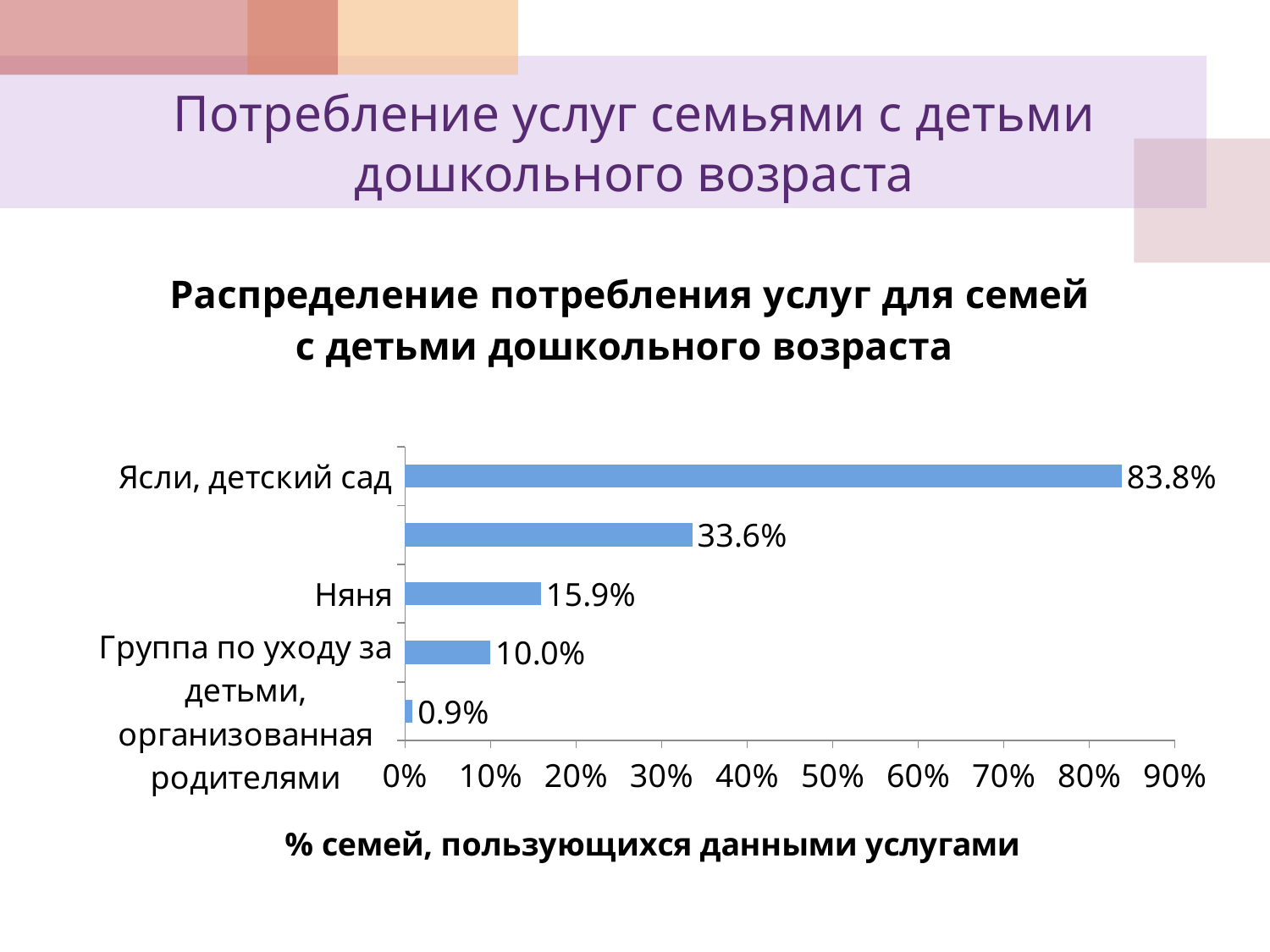
What is the value for "Ясли, детский сад"? 83.8% What is the value of the shortest bar? 0.9% What is the difference between the values for "Ясли, детский сад" and "Няня"? 67.9% Which is larger, the value for "Ясли, детский сад" or the value for "Няня"? Ясли, детский сад How many bars are plotted in the chart? 5 What is the label of the horizontal axis? % семей, пользующихся данными услугами What is the value of the longest bar? 83.8% What is the value for "Няня"? 15.9% What type of chart is shown on the slide? bar chart What is the title of the chart? Распределение потребления услуг для семей с детьми дошкольного возраста Which category has the highest value? Ясли, детский сад Is the value for "Няня" greater or less than 20%? less